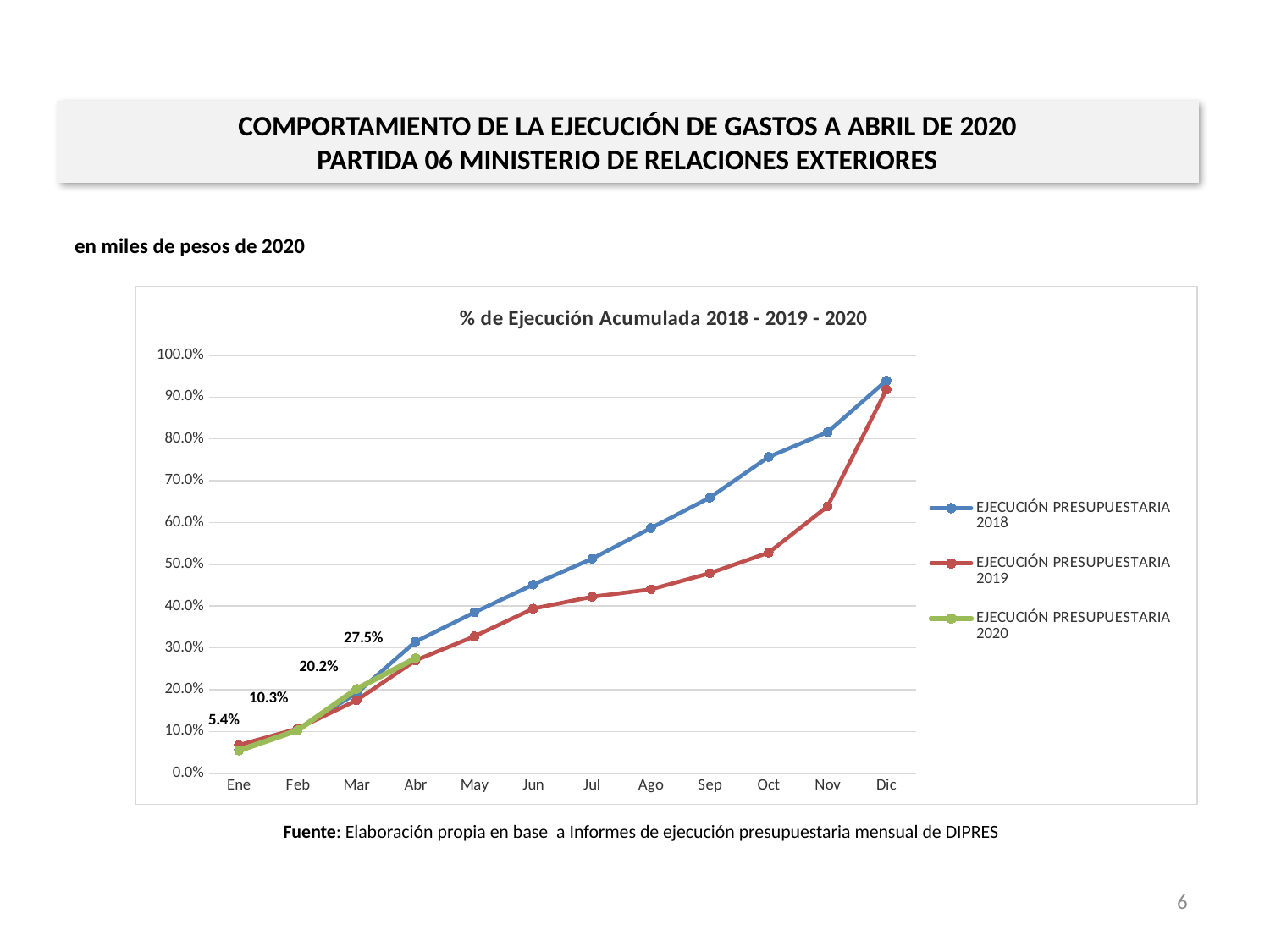
What is the value for EJECUCIÓN PRESUPUESTARIA 2020 in Abr? 27.5% Is the value for EJECUCIÓN PRESUPUESTARIA 2019 in Ago greater or less than 50.0%? less What type of chart is shown on the slide? Line chart How many series does the legend list? 3 What is the value for EJECUCIÓN PRESUPUESTARIA 2020 in Feb? 10.3% What is the value for EJECUCIÓN PRESUPUESTARIA 2020 in Mar? 20.2% In Oct, which series has the higher value, EJECUCIÓN PRESUPUESTARIA 2018 or EJECUCIÓN PRESUPUESTARIA 2019? EJECUCIÓN PRESUPUESTARIA 2018 By how many percentage points did EJECUCIÓN PRESUPUESTARIA 2020 increase from Mar to Abr? 7.3 percentage points What is the value for EJECUCIÓN PRESUPUESTARIA 2020 in Ene? 5.4% Is the value for EJECUCIÓN PRESUPUESTARIA 2018 in Dic greater or less than 90.0%? greater How many months are shown on the x axis? 12 Does the EJECUCIÓN PRESUPUESTARIA 2018 line rise or fall from Ene to Dic? Rise